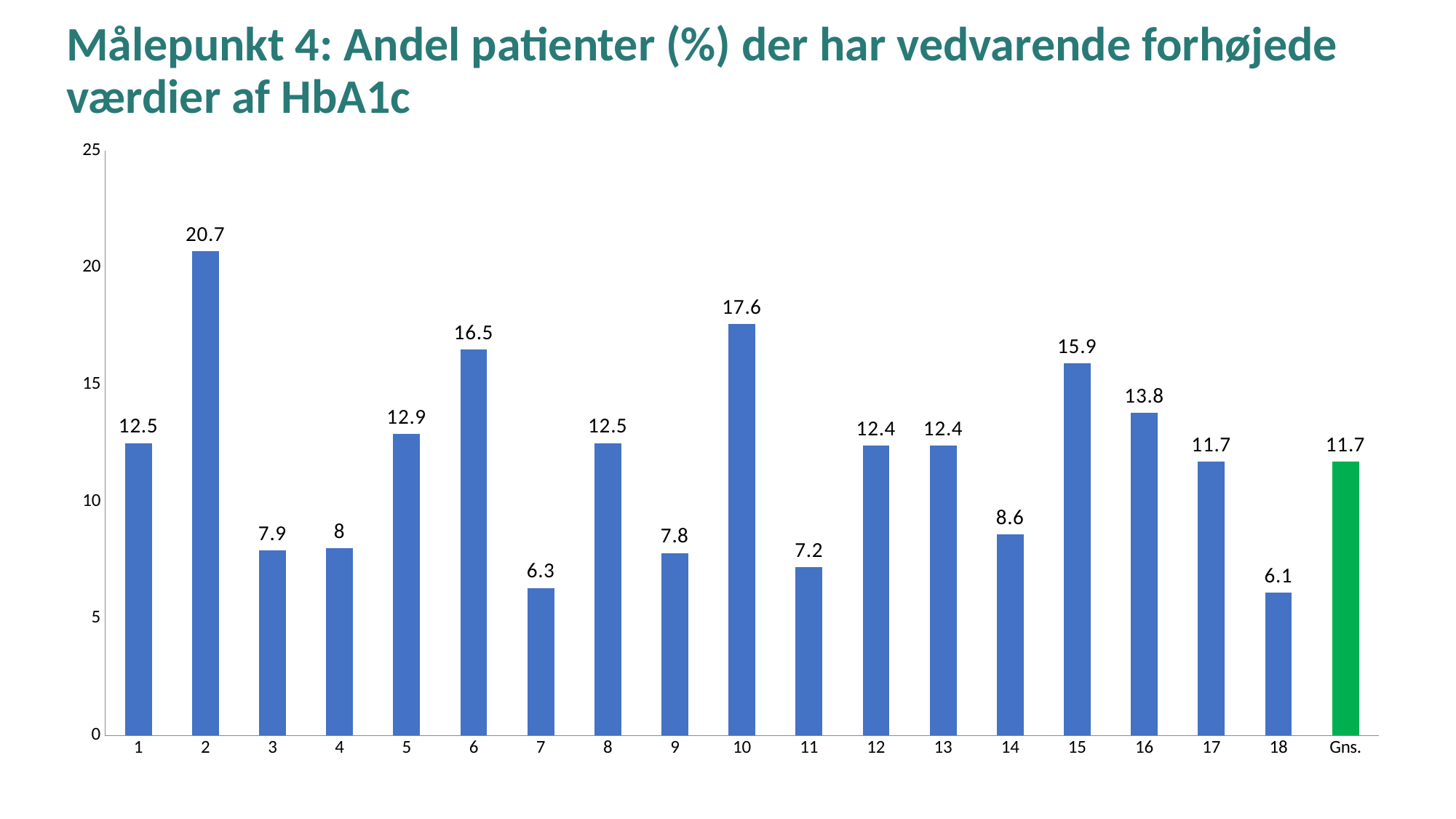
Is the value for category 7 greater or less than 10? less Which category has the highest value? 2 What is the value for category 2? 20.7 Which bar is coloured green? Gns. How many bars are shown in the chart? 19 What is the difference between the values for category 2 and category 18? 14.6 Which category has the lowest value? 18 What is the value for category 10? 17.6 What kind of chart is shown on the slide? bar chart What is the difference between the values for category 6 and category 15? 0.6 Which is larger, the value for category 5 or the value for category 14? 5 What is the value shown for Gns.? 11.7